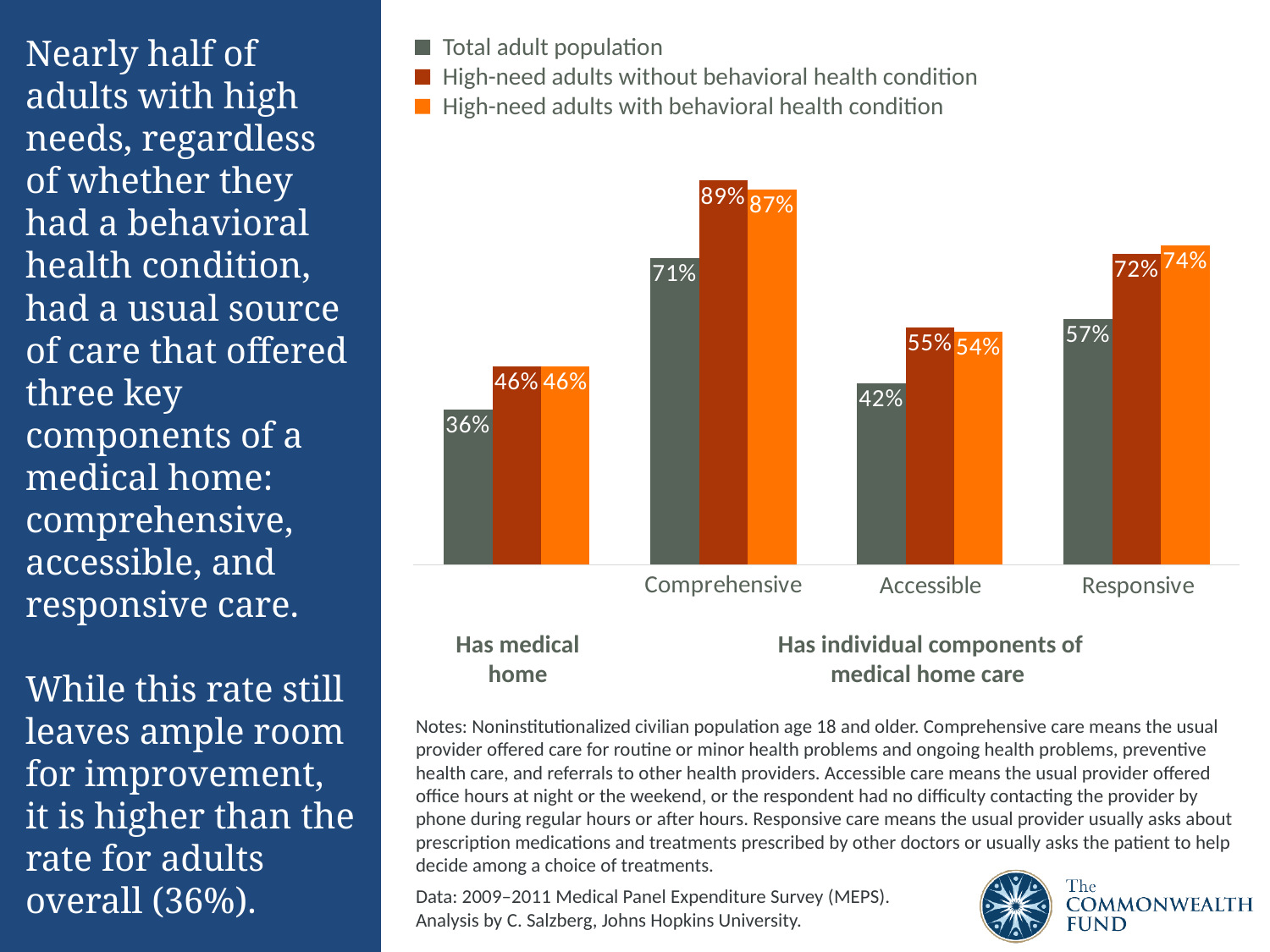
How many series does the legend list? 3 In which category is the value for high-need adults without behavioral health condition highest? Comprehensive What is the value for the total adult population in the Comprehensive category? 71% What kind of chart is shown on the slide? Bar chart How many category groups of bars are shown in the chart? 4 In which category is the value for the total adult population lowest? Has medical home What is the value for high-need adults with behavioral health condition in the Responsive category? 74% In the Responsive category, which is larger: the value for high-need adults with behavioral health condition or without behavioral health condition? High-need adults with behavioral health condition Which colour represents high-need adults with behavioral health condition in the legend? Orange What is the difference between the values for high-need adults without behavioral health condition and the total adult population in the Comprehensive category? 18% What is the value for the total adult population in the 'Has medical home' group? 36% What is the value for high-need adults without behavioral health condition in the Accessible category? 55%